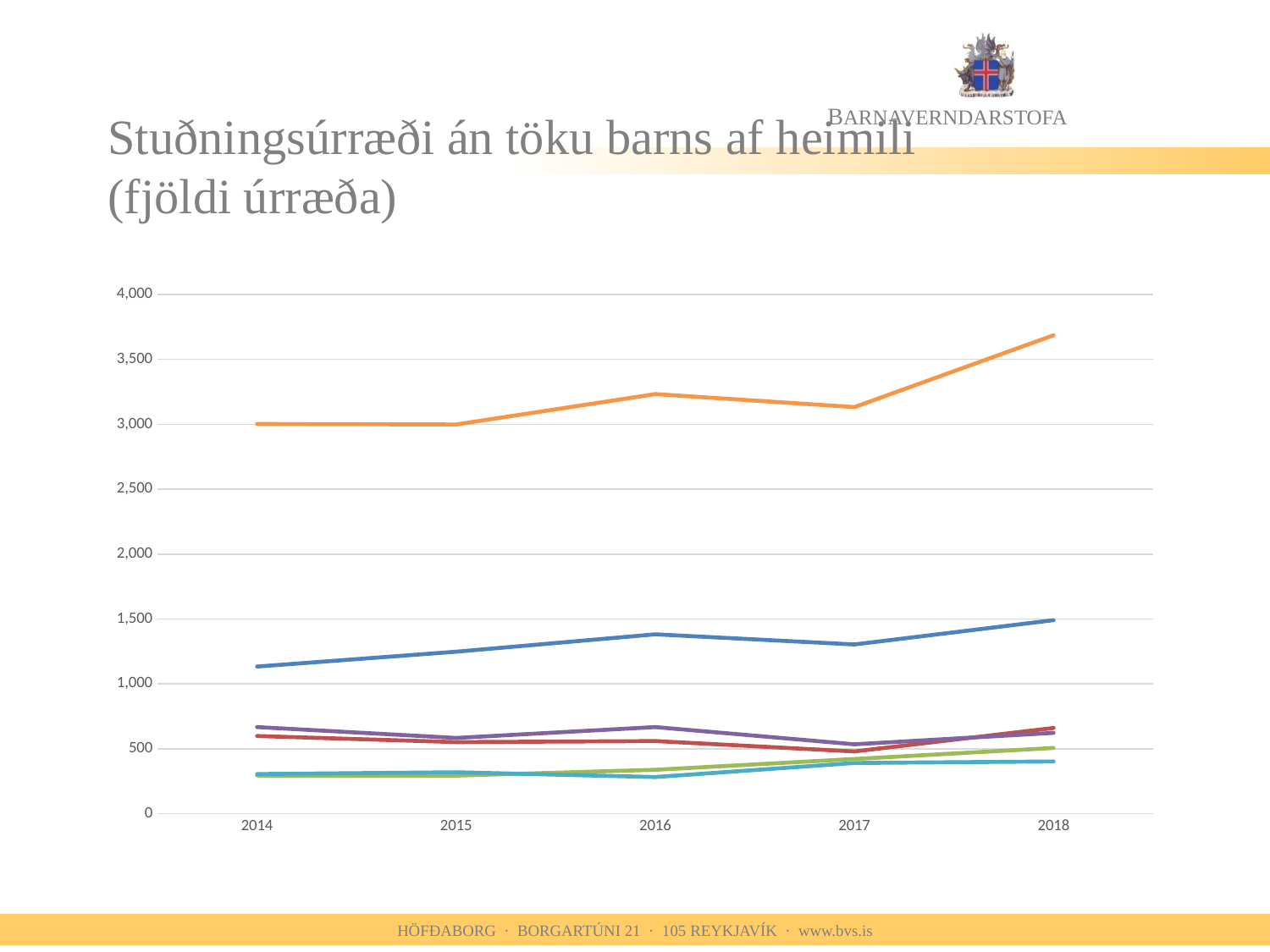
Is the value of the blue line in 2014 greater or less than 1,000? greater In 2018, which is larger: the value of the orange line or the value of the blue line? the orange line What kind of chart is shown on the slide? line chart Is the value of the orange line in 2016 greater or less than 3,000? greater Which line has the highest values across all years on the chart? the orange line How many years are shown on the x axis of the chart? 5 Is the value of the orange line in 2018 greater or less than 3,500? greater What is the title of the chart on the slide? Stuðningsúrræði án töku barns af heimili (fjöldi úrræða) In which year does the orange line reach its highest value? 2018 Does the orange line rise or fall overall from 2014 to 2018? rise How many lines are plotted on the chart? 6